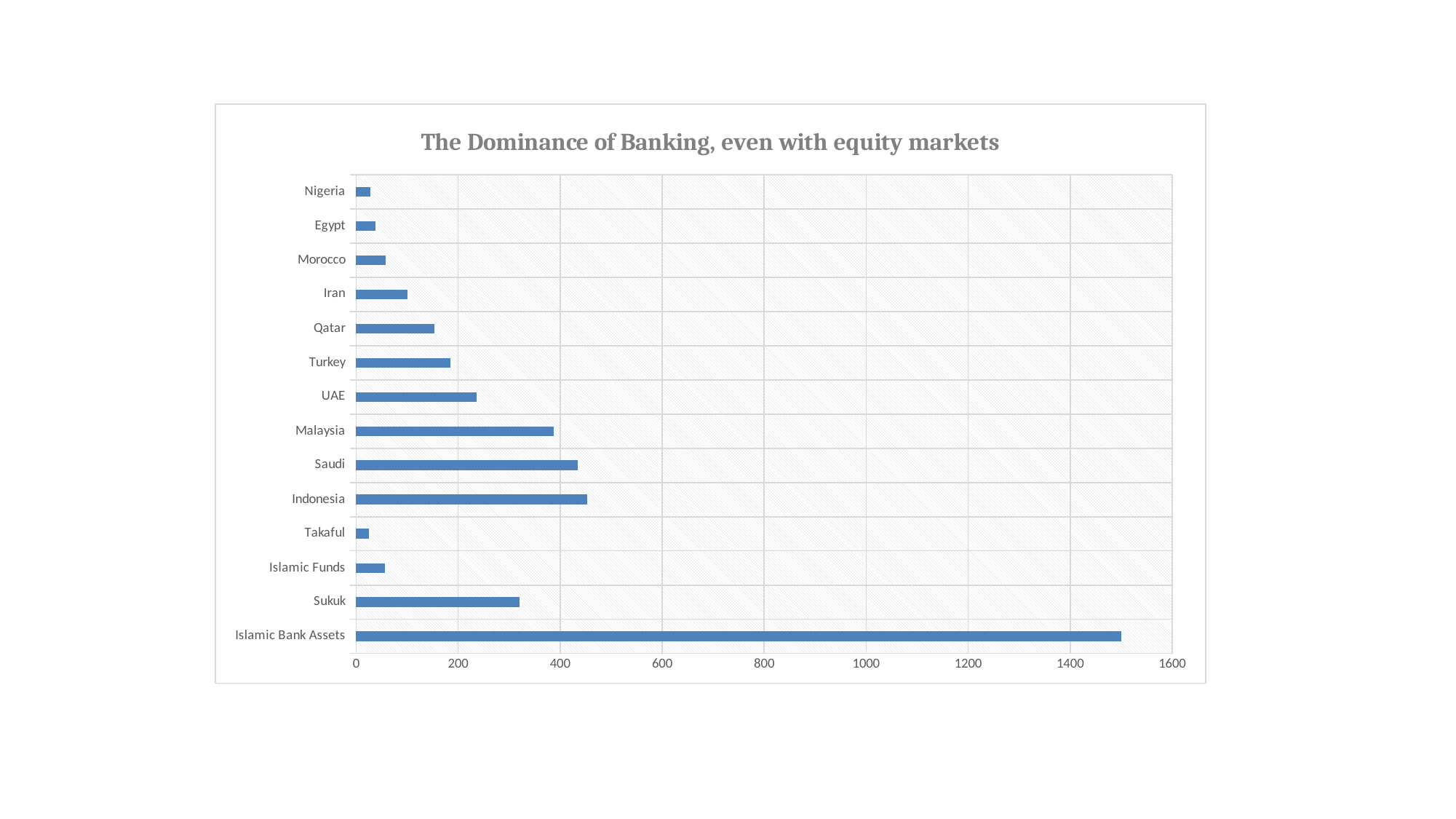
Which has the larger value, Qatar or Iran? Qatar Which has the larger value, UAE or Turkey? UAE Is the value for UAE greater or less than 200? greater Is the value for Sukuk greater or less than 400? less What kind of chart is shown on the slide? bar chart Is the value for Islamic Bank Assets greater or less than 1400? greater Which has the larger value, Sukuk or Malaysia? Malaysia How many categories are plotted in the chart? 14 What is the title of the chart? The Dominance of Banking, even with equity markets Which category has the highest value? Islamic Bank Assets